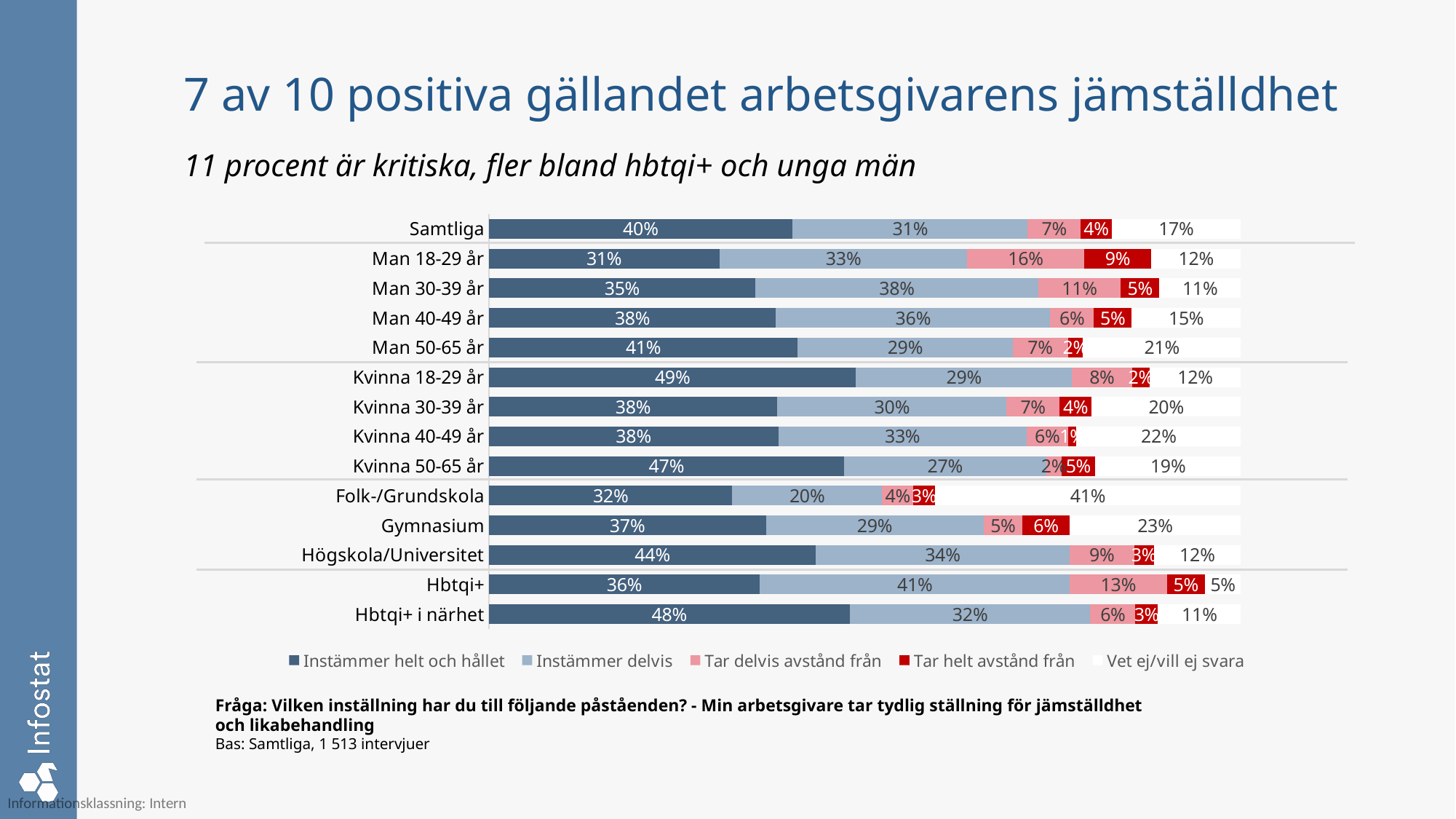
What kind of chart is shown on the slide? Stacked bar chart How many categories (rows) are plotted in the chart? 14 What is the value of 'Instämmer delvis' for Hbtqi+? 41% What is the difference in 'Instämmer helt och hållet' between Kvinna 18-29 år and Man 18-29 år? 18 percentage points What is the value of 'Tar delvis avstånd från' for Man 18-29 år? 16% What is the value of 'Vet ej/vill ej svara' for Folk-/Grundskola? 41% Which category has the highest value for 'Tar helt avstånd från'? Man 18-29 år What is the value of 'Instämmer helt och hållet' for Samtliga? 40% Which category has the highest value for 'Instämmer helt och hållet'? Kvinna 18-29 år Which has a larger 'Instämmer helt och hållet' value, Hbtqi+ or Hbtqi+ i närhet? Hbtqi+ i närhet How many series does the legend list? 5 Which category has the lowest value for 'Vet ej/vill ej svara'? Hbtqi+